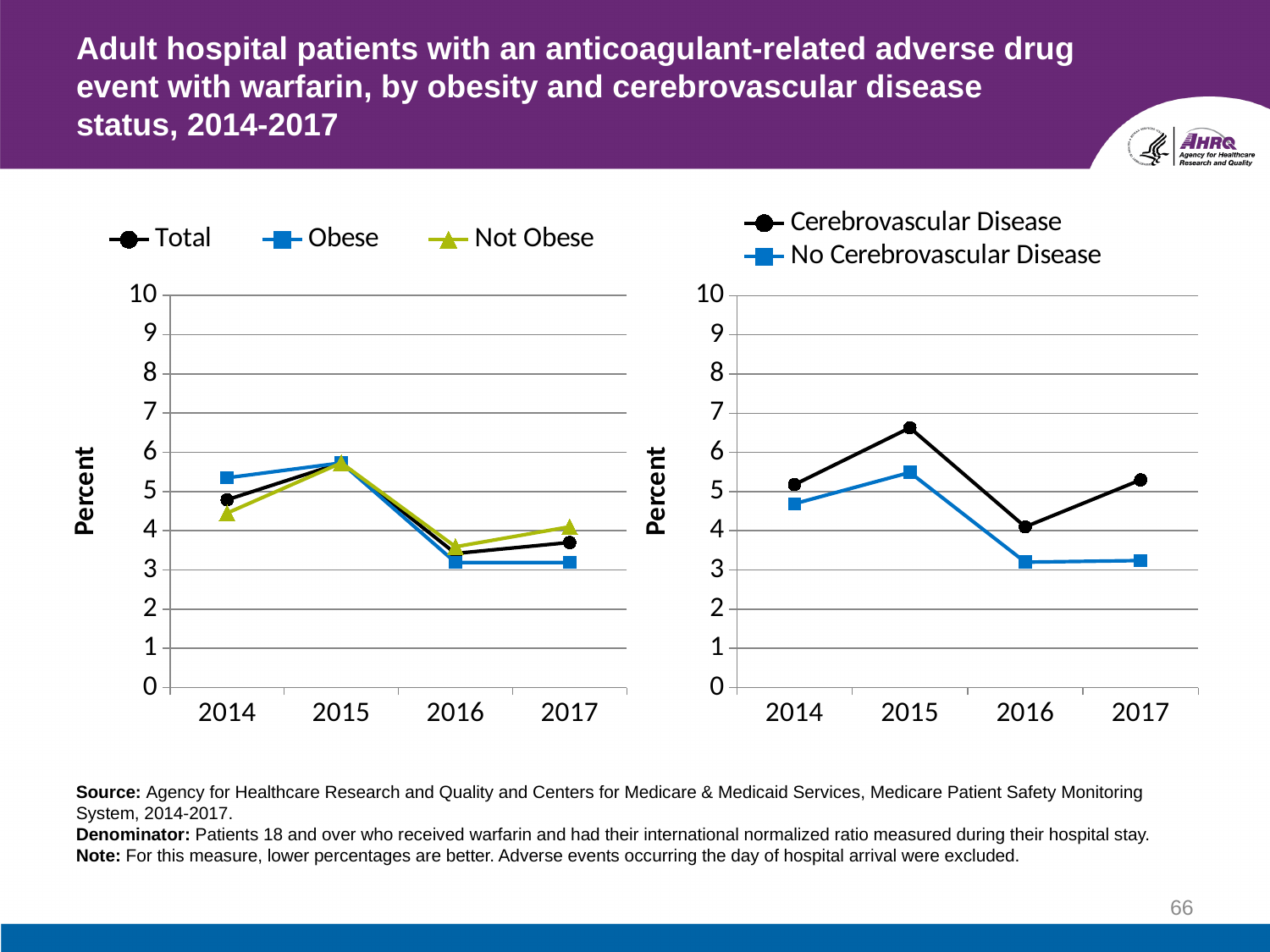
In the left chart, is the value for Obese in 2014 greater or less than 5? greater What is the y-axis label on the left chart? Percent In the right chart, is the value for Cerebrovascular Disease in 2015 greater or less than 6? greater In the right chart, does the Cerebrovascular Disease series rise or fall from 2015 to 2016? fall How many series does the legend of the right chart (Cerebrovascular Disease) list? 2 How many years are shown on the x axis of the left chart? 4 In the right chart, in which year is the Cerebrovascular Disease series highest? 2015 In the right chart, is the value for No Cerebrovascular Disease in 2016 greater or less than 4? less In the right chart, which series has the higher value in 2015, Cerebrovascular Disease or No Cerebrovascular Disease? Cerebrovascular Disease In the left chart, which series has the highest value in 2014? Obese How many series does the legend of the left chart list? 3 What kind of chart is the left chart (Total, Obese, Not Obese)? line chart